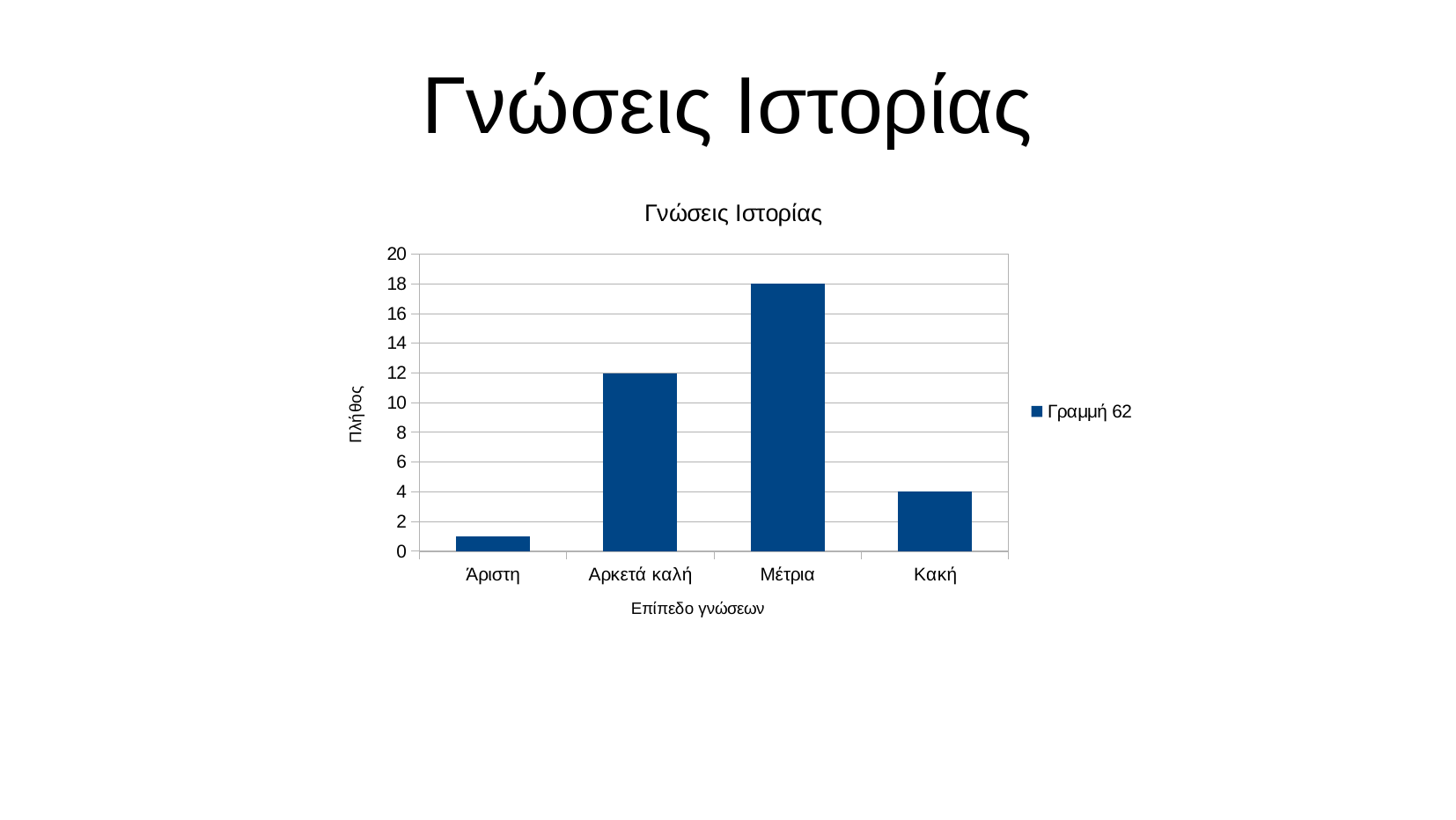
Is the value for Άριστη greater or less than 2? less What is the value for Κακή? 4 What kind of chart is shown on the slide? bar chart Which category has the lowest value? Άριστη What is the difference between the values for Μέτρια and Αρκετά καλή? 6 Which category has the highest value? Μέτρια What is the title of the chart? Γνώσεις Ιστορίας Which is larger, the value for Κακή or the value for Άριστη? Κακή What is the value for Αρκετά καλή? 12 What is the value for Μέτρια? 18 How many categories are shown on the x axis? 4 What is the difference between the values for Αρκετά καλή and Κακή? 8